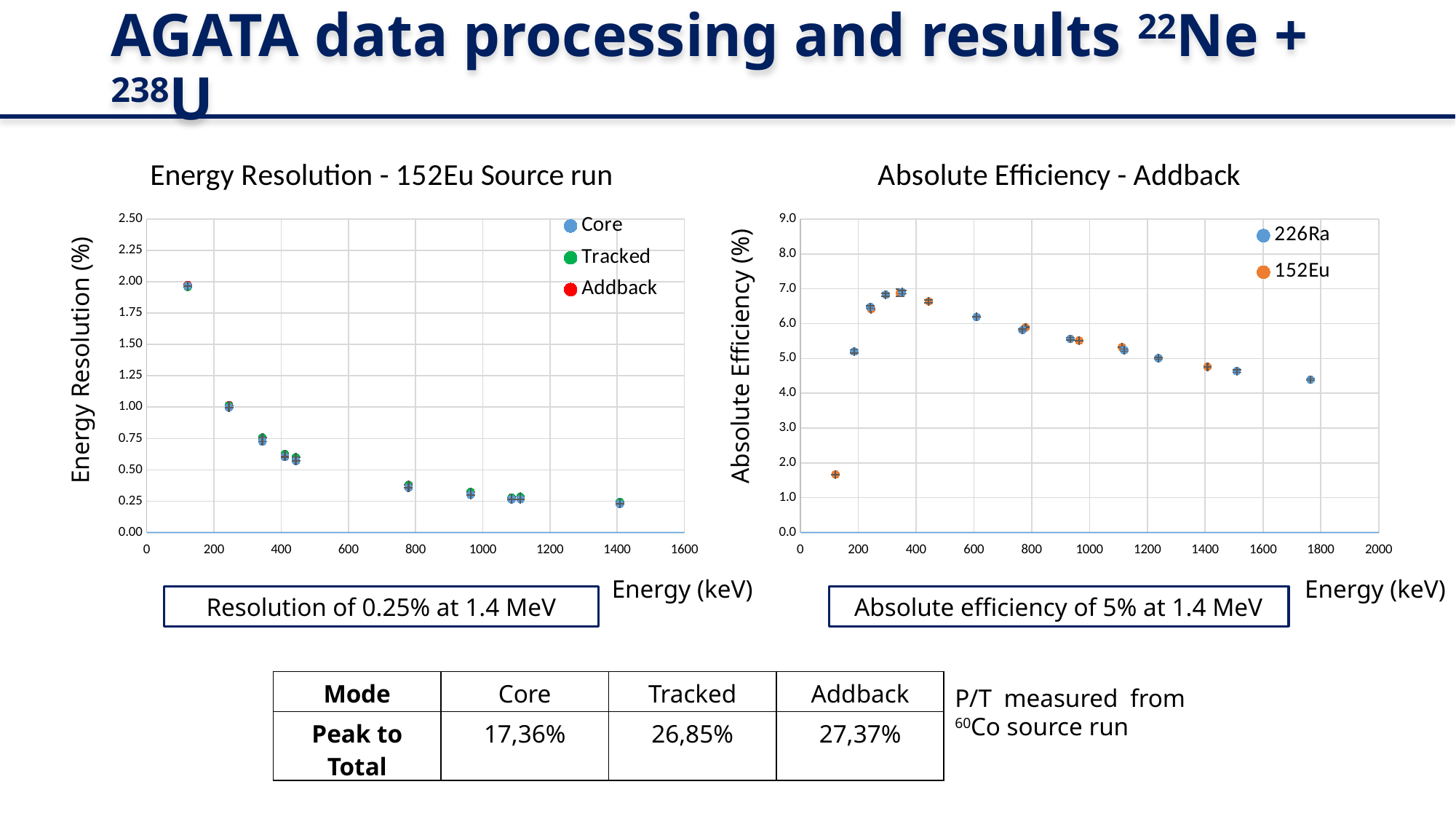
In the 'Absolute Efficiency - Addback' chart, does the absolute efficiency rise or fall as energy increases from about 400 keV to 1800 keV? fall How many series does the legend of the 'Energy Resolution - 152Eu Source run' chart list? 3 In the 'Energy Resolution - 152Eu Source run' chart, does the energy resolution rise or fall as energy increases along the x axis? fall In the 'Absolute Efficiency - Addback' chart, which is larger: the absolute efficiency at about 350 keV or at about 1750 keV? about 350 keV What kind of chart is the 'Energy Resolution - 152Eu Source run' chart? scatter chart In the 'Absolute Efficiency - Addback' chart, is the absolute efficiency at about 350 keV greater or less than 6.0%? greater In the 'Energy Resolution - 152Eu Source run' chart, is the energy resolution at the lowest-energy point (around 120 keV) greater or less than 1.75%? greater What are the series names in the legend of the 'Absolute Efficiency - Addback' chart? 226Ra, 152Eu In the 'Absolute Efficiency - Addback' chart, is the absolute efficiency at the lowest-energy point (around 120 keV) greater or less than 2.0%? less What are the series names in the legend of the 'Energy Resolution - 152Eu Source run' chart? Core, Tracked, Addback How many series does the legend of the 'Absolute Efficiency - Addback' chart list? 2